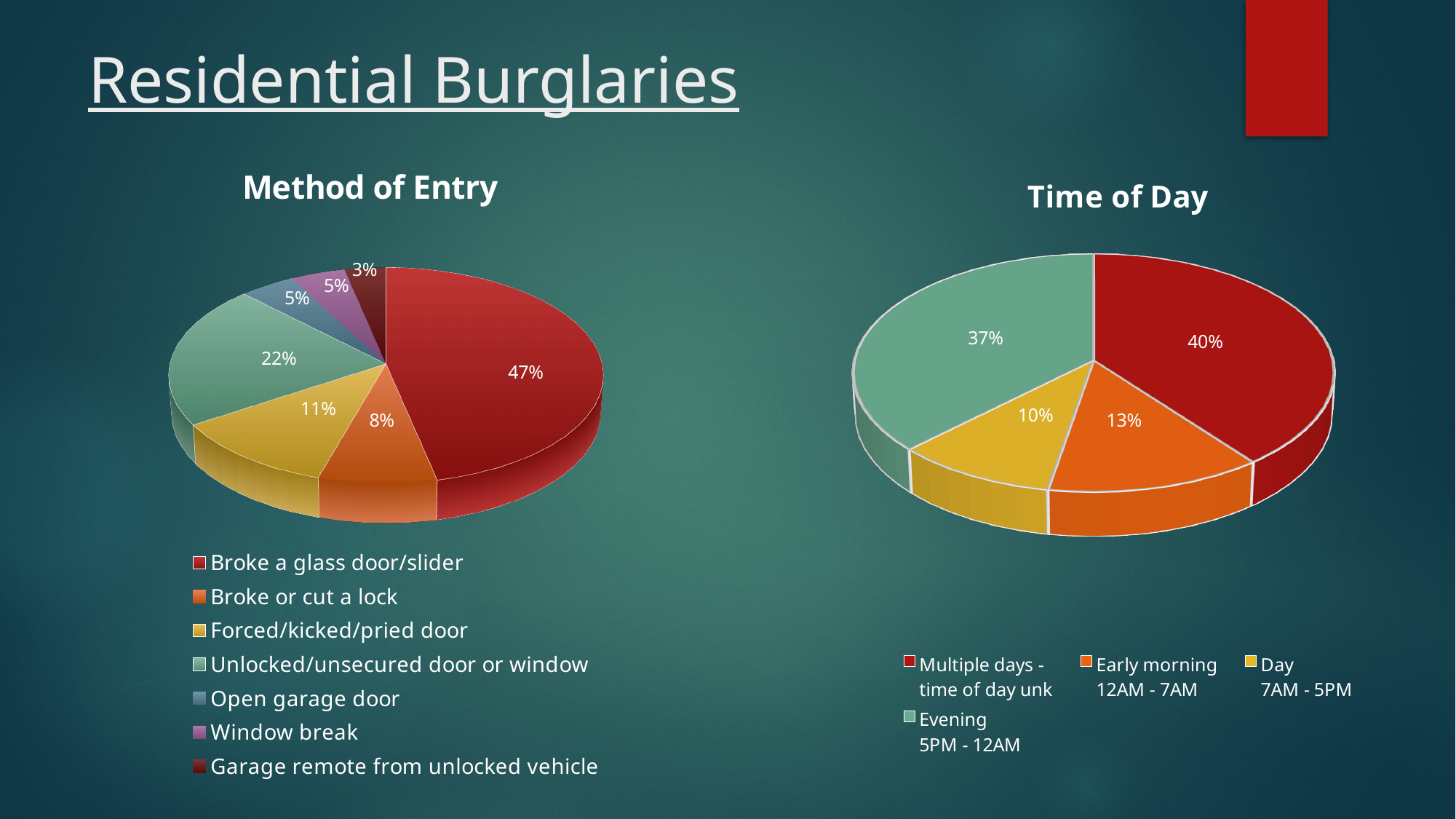
In the Method of Entry chart, what is the difference in percentage points between Broke a glass door/slider and Unlocked/unsecured door or window? 25 In the Time of Day chart, what percentage is shown for Early morning 12AM - 7AM? 13% In the Method of Entry chart, what share of burglaries involved breaking a glass door/slider? 47% In the Method of Entry chart, which method of entry has the smallest share? Garage remote from unlocked vehicle In the Method of Entry chart, what percentage is shown for Forced/kicked/pried door? 11% In the Time of Day chart, how many slices does the pie have? 4 What type of chart is the Time of Day chart? Pie chart In the Time of Day chart, which is larger: Early morning 12AM - 7AM or Day 7AM - 5PM? Early morning 12AM - 7AM In the Method of Entry chart, what percentage is shown for Unlocked/unsecured door or window? 22% In the Time of Day chart, which category has the largest share? Multiple days - time of day unk In the Method of Entry chart, how many categories does the legend list? 7 In the Time of Day chart, what percentage of burglaries occurred in the Evening (5PM - 12AM)? 37%